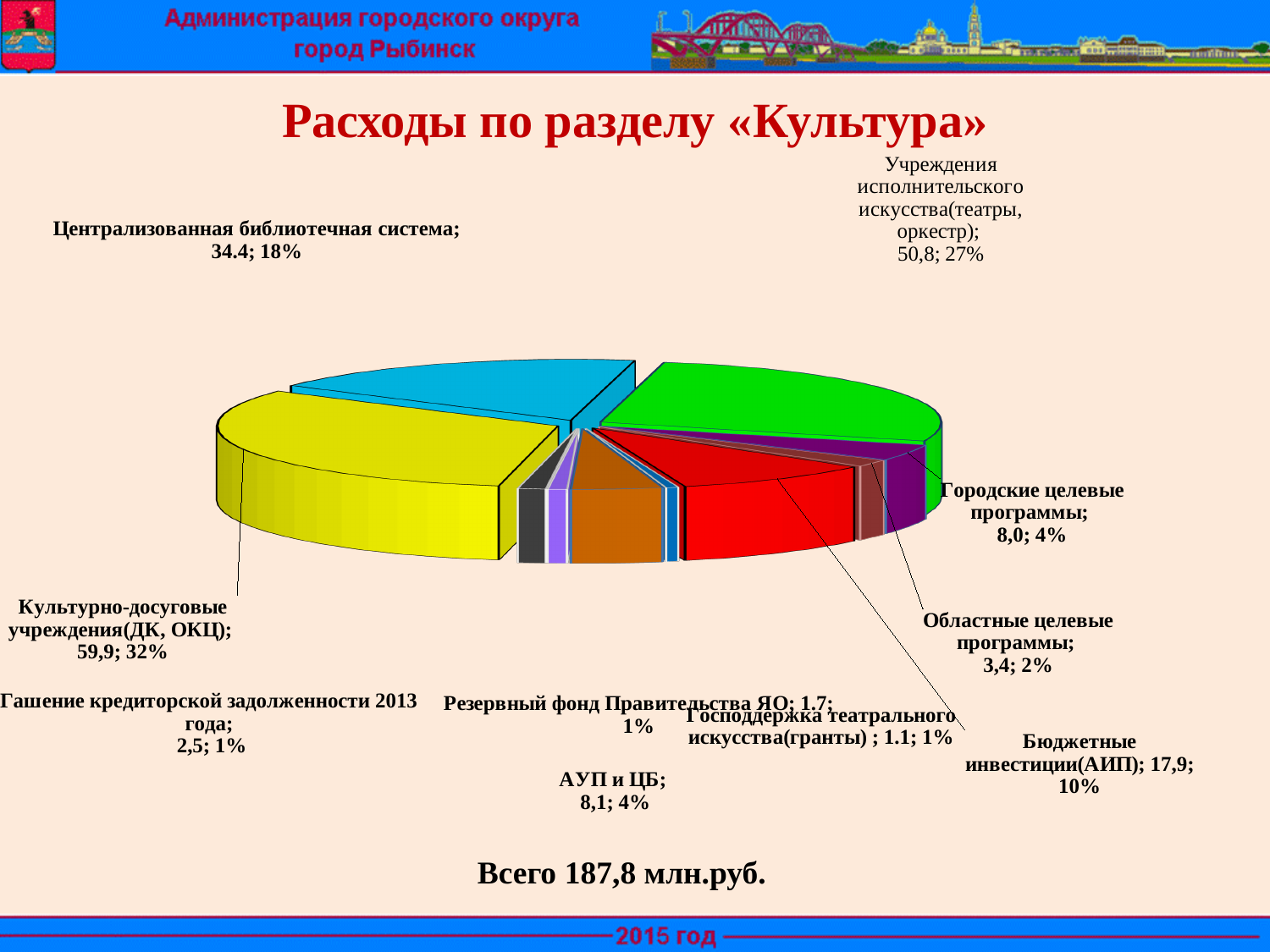
Which category has the largest share of the pie? Культурно-досуговые учреждения(ДК, ОКЦ) What is the value for «Бюджетные инвестиции(АИП)»? 17,9 What is the difference between the values for «Культурно-досуговые учреждения(ДК, ОКЦ)» and «Учреждения исполнительского искусства(театры, оркестр)»? 9,1 Which category has the smallest value? Господдержка театрального искусства(гранты) What kind of chart is shown on the slide? pie chart What is the title of the chart? Расходы по разделу «Культура» What share of the pie does «Централизованная библиотечная система» represent? 18% What share of the pie does «Учреждения исполнительского искусства(театры, оркестр)» represent? 27% How many categories are shown in the pie chart? 10 What is the value for «Культурно-досуговые учреждения(ДК, ОКЦ)»? 59,9 Which is larger: «Городские целевые программы» or «Областные целевые программы»? Городские целевые программы What is the total amount stated below the chart? 187,8 млн.руб.